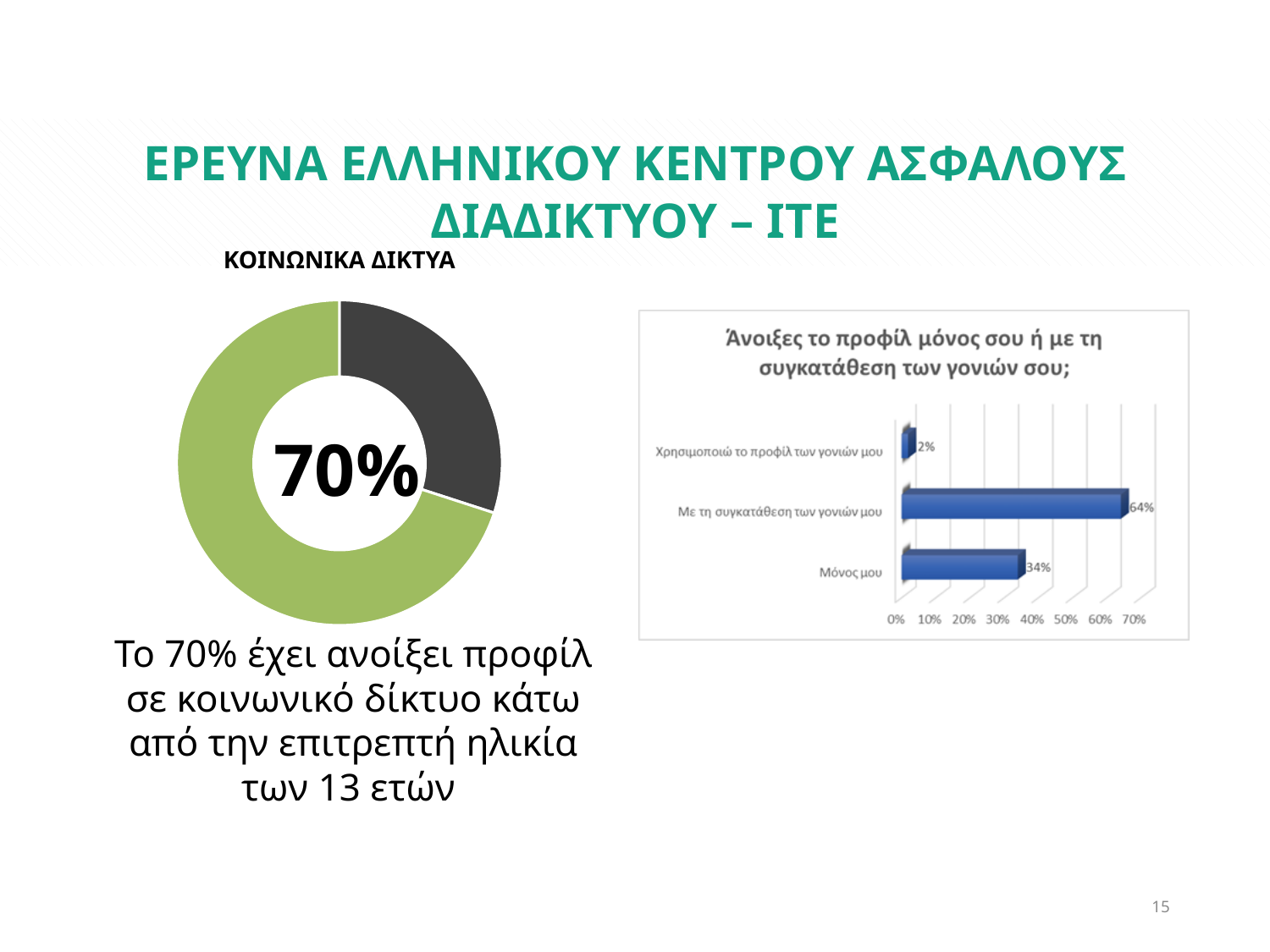
In the bar chart on the right, which category has the lowest value? Χρησιμοποιώ το προφίλ των γονιών μου What is the title of the bar chart on the right? Άνοιξες το προφίλ μόνος σου ή με τη συγκατάθεση των γονιών σου; In the bar chart on the right, what is the difference between the values for 'Με τη συγκατάθεση των γονιών μου' and 'Μόνος μου'? 30% In the bar chart on the right, is the value for 'Μόνος μου' greater or less than 50%? less What kind of chart is the chart on the right of the slide? bar chart How many categories does the bar chart on the right show? 3 In the bar chart on the right, which is larger: the value for 'Μόνος μου' or the value for 'Χρησιμοποιώ το προφίλ των γονιών μου'? Μόνος μου In the bar chart on the right, what is the value for 'Χρησιμοποιώ το προφίλ των γονιών μου'? 2% In the bar chart on the right, what is the value for 'Μόνος μου'? 34% In the bar chart on the right, what is the value for 'Με τη συγκατάθεση των γονιών μου'? 64% In the donut chart on the left, what share is shown by the green slice? 70% In the bar chart on the right, which category has the highest value? Με τη συγκατάθεση των γονιών μου